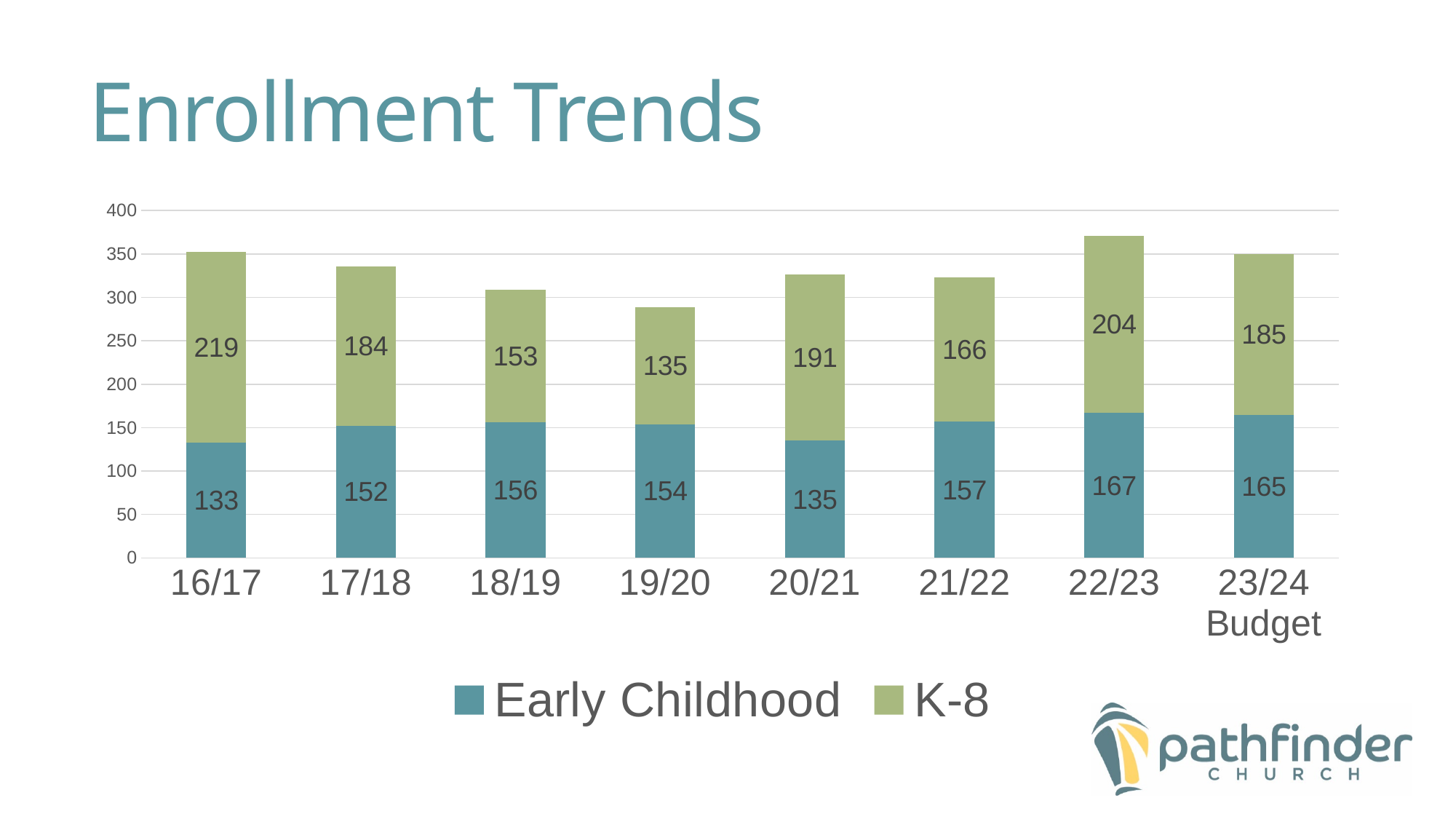
What is the difference between the K-8 values for 22/23 and 21/22? 38 Which year has the highest K-8 enrollment? 16/17 What is the K-8 enrollment value for 16/17? 219 How many series does the legend list? 2 What is the total enrollment (Early Childhood plus K-8) for 19/20? 289 What is the Early Childhood value for 23/24 Budget? 165 How many year categories are shown on the x axis? 8 What is the total enrollment (Early Childhood plus K-8) for 22/23? 371 Which year has the lowest Early Childhood enrollment? 16/17 Which is larger, the K-8 value for 19/20 or the K-8 value for 18/19? 18/19 What kind of chart is shown on the slide? Stacked bar chart What is the Early Childhood enrollment value for 20/21? 135